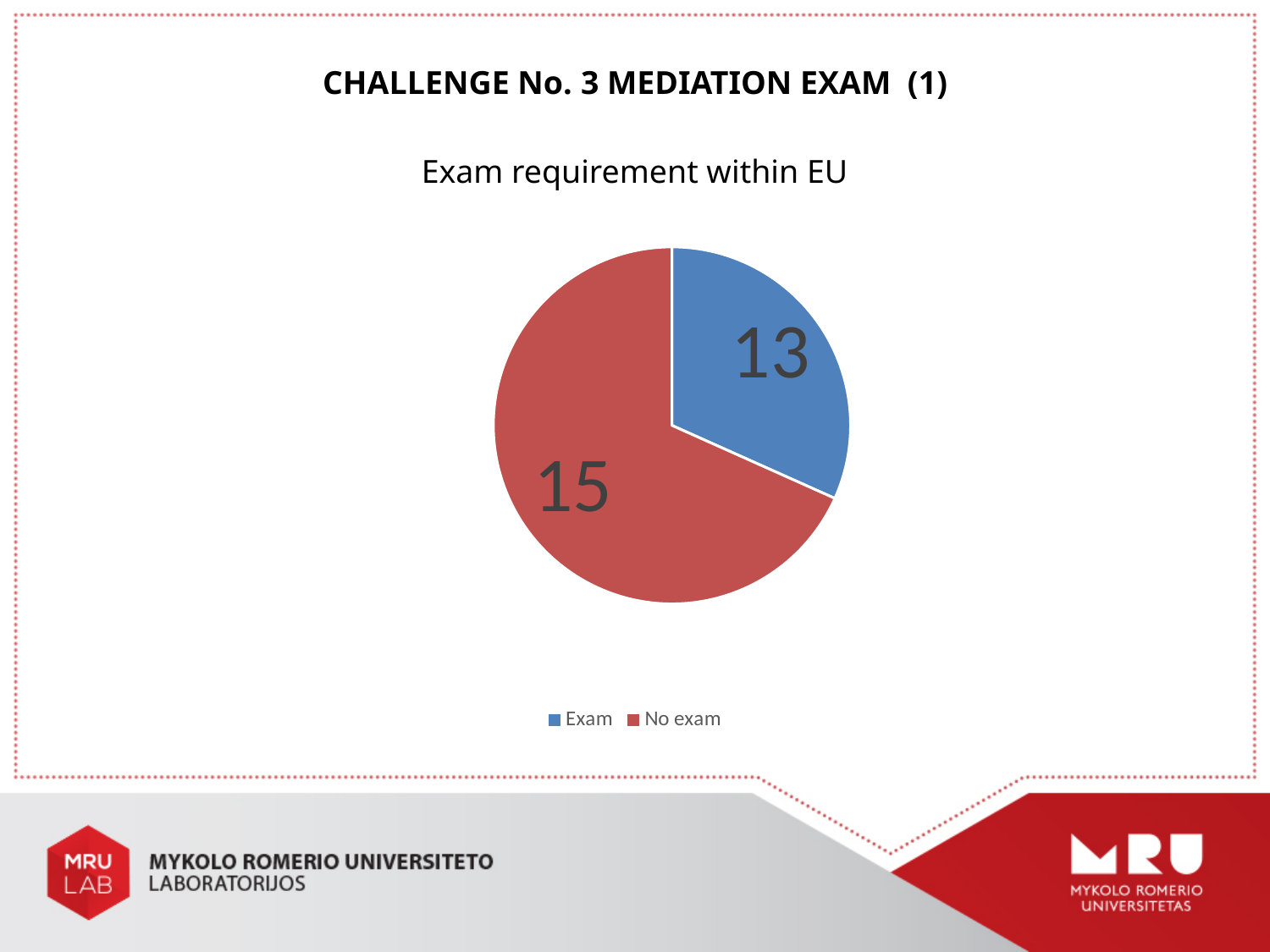
Which category has the smaller slice? Exam Which category has the larger slice? No exam What is the difference between the No exam and Exam values? 2 What is the value for the No exam slice? 15 What is the value for the Exam slice? 13 How many slices does the pie chart have? 2 What is the total of the two slices? 28 What colour is the No exam slice? red What kind of chart is shown on the slide? pie chart How many entries does the legend list? 2 What is the title of the chart? Exam requirement within EU Is the value for No exam larger or smaller than the value for Exam? larger